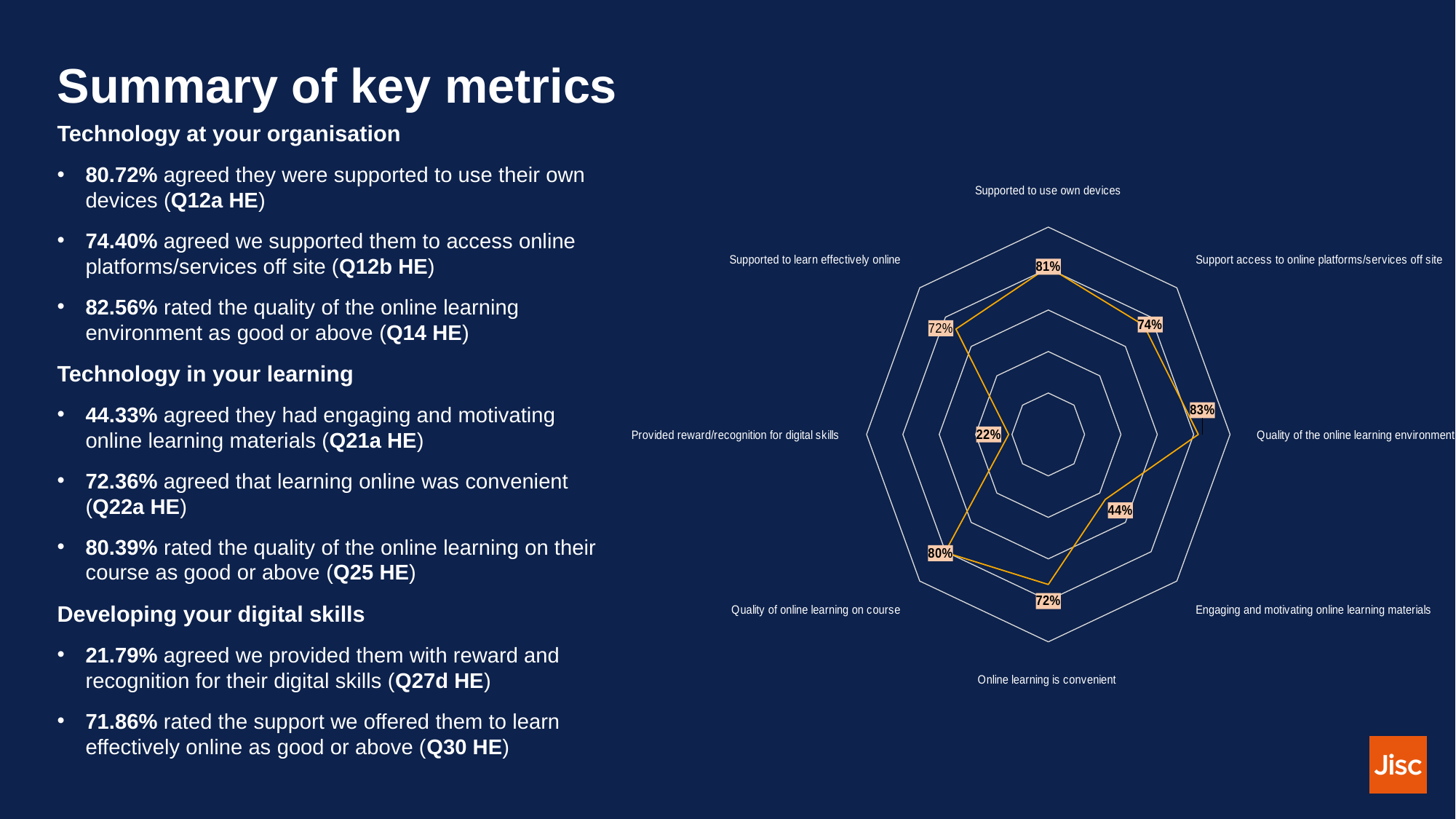
What is the value for 'Engaging and motivating online learning materials' on the radar chart? 44% What is the value for 'Quality of the online learning environment' on the radar chart? 83% How many categories are plotted on the radar chart? 8 Which category has the lowest value on the radar chart? Provided reward/recognition for digital skills Which category has the highest value on the radar chart? Quality of the online learning environment What kind of chart is shown on the slide? Radar chart What is the value for 'Quality of online learning on course' on the radar chart? 80% What is the difference between the highest and lowest values on the radar chart? 61 percentage points What is the value for 'Supported to use own devices' on the radar chart? 81% What is the difference between the values for 'Supported to use own devices' and 'Support access to online platforms/services off site' on the radar chart? 7 percentage points Which is larger on the radar chart: the value for 'Quality of online learning on course' or the value for 'Engaging and motivating online learning materials'? Quality of online learning on course What is the value for 'Provided reward/recognition for digital skills' on the radar chart? 22%